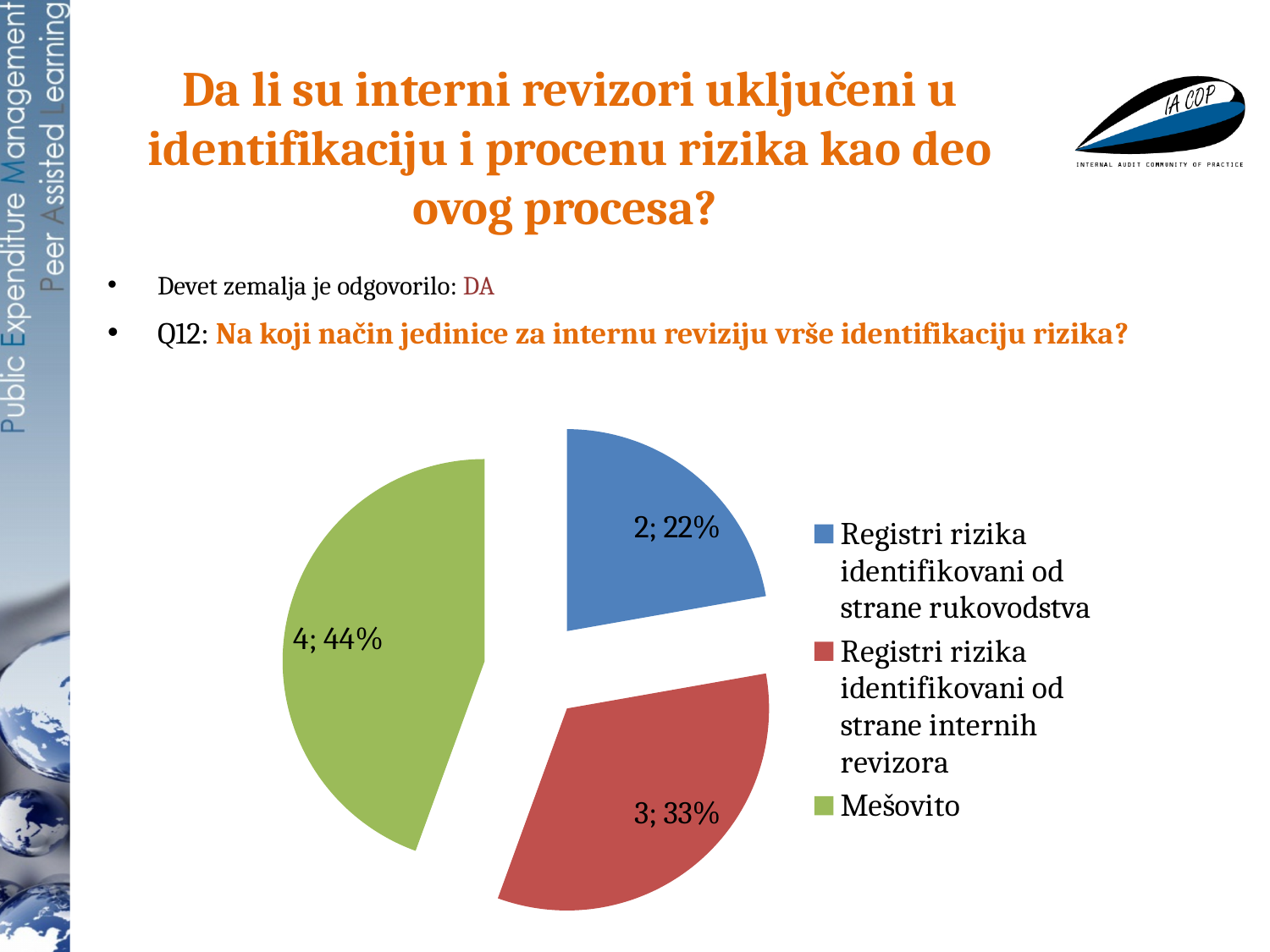
What percentage share does 'Registri rizika identifikovani od strane rukovodstva' have? 22% What is the count shown for 'Registri rizika identifikovani od strane internih revizora'? 3 Which category has the smallest slice of the pie? Registri rizika identifikovani od strane rukovodstva What percentage share does the 'Mešovito' slice have? 44% What kind of chart is shown on the slide? pie chart What percentage share does 'Registri rizika identifikovani od strane internih revizora' have? 33% What is the difference in count between 'Mešovito' and 'Registri rizika identifikovani od strane rukovodstva'? 2 Which colour represents the 'Mešovito' slice in the legend? green How many slices does the pie chart have? 3 What is the count shown for 'Registri rizika identifikovani od strane rukovodstva'? 2 Which category has the largest slice of the pie? Mešovito What is the count shown for the 'Mešovito' slice? 4